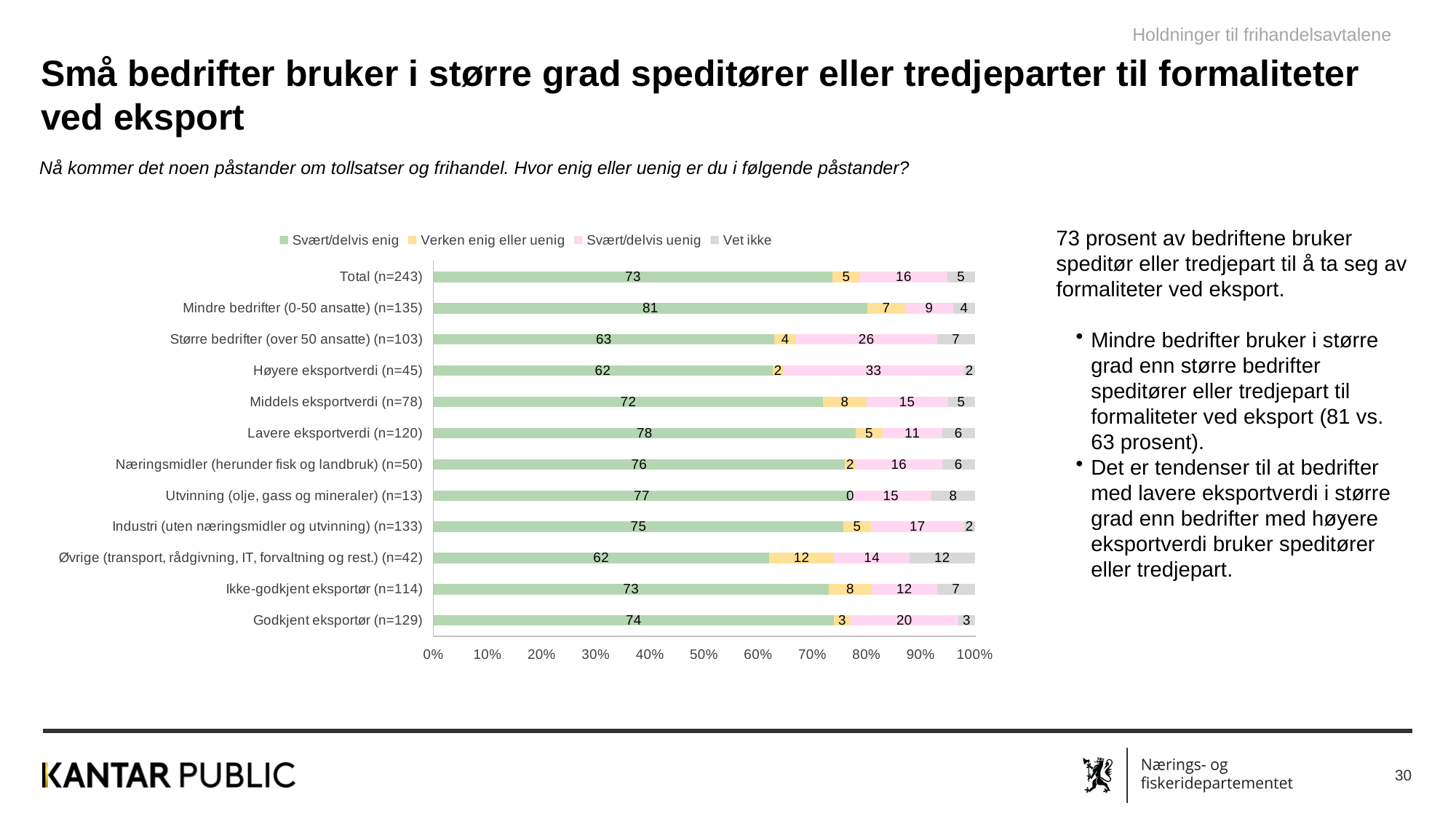
Which category has the highest Svært/delvis enig value? Mindre bedrifter (0-50 ansatte) (n=135) What is the Vet ikke value for Utvinning (olje, gass og mineraler) (n=13)? 8 Which category has the lowest Svært/delvis uenig value? Mindre bedrifter (0-50 ansatte) (n=135) What is the Svært/delvis uenig value for Høyere eksportverdi (n=45)? 33 What is the difference between the Svært/delvis enig values for Mindre bedrifter (0-50 ansatte) (n=135) and Større bedrifter (over 50 ansatte) (n=103)? 18 Which legend entry is shown in green? Svært/delvis enig How many series does the legend list? 4 What is the Svært/delvis enig value for Total (n=243)? 73 How many categories are shown on the chart? 12 What kind of chart is shown on the slide? Stacked bar chart What is the Verken enig eller uenig value for Øvrige (transport, rådgivning, IT, forvaltning og rest.) (n=42)? 12 Which has a larger Svært/delvis uenig value: Godkjent eksportør (n=129) or Ikke-godkjent eksportør (n=114)? Godkjent eksportør (n=129)